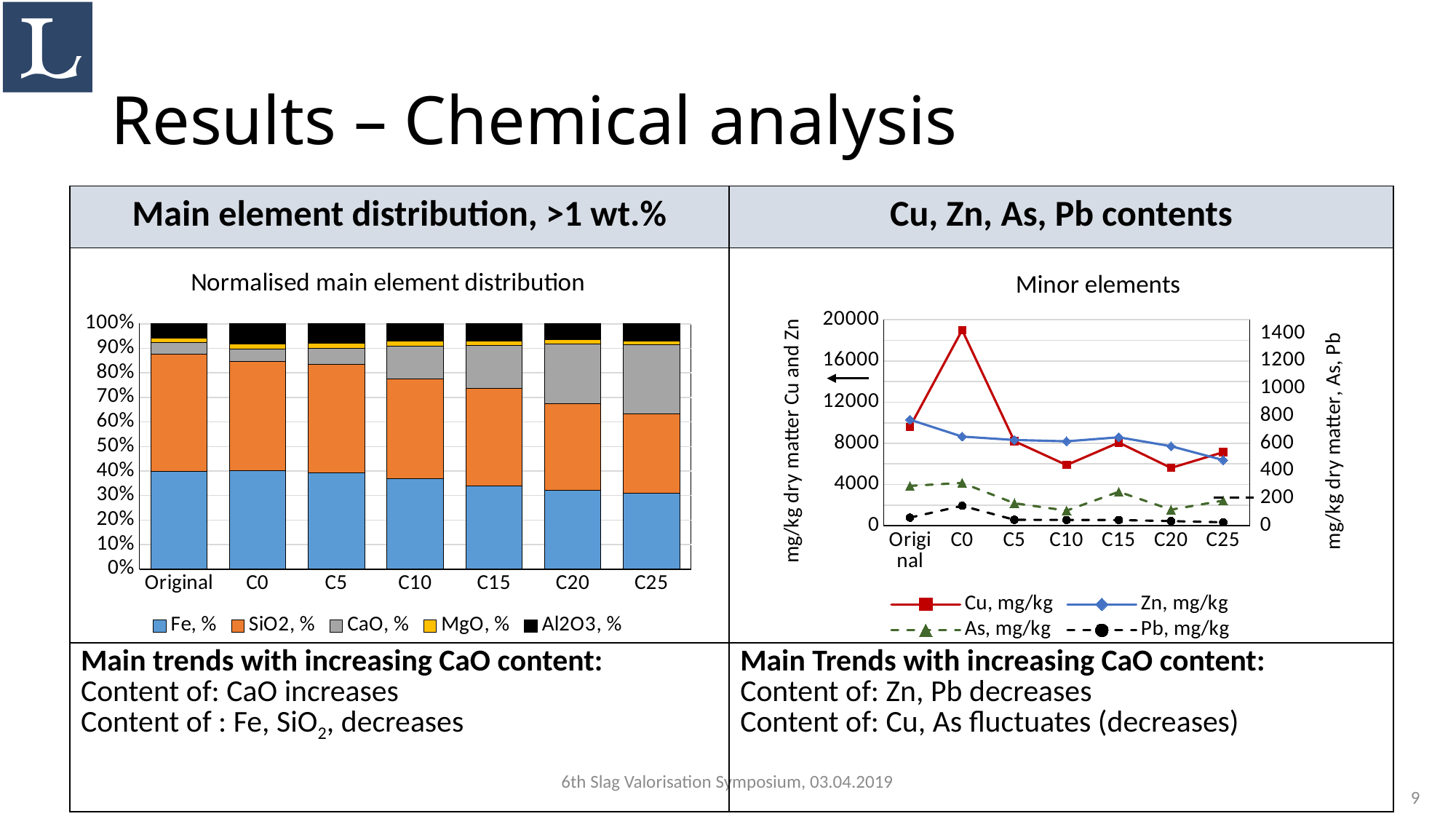
In the 'Minor elements' chart, does Zn, mg/kg generally rise or fall from Original to C25? fall In the 'Normalised main element distribution' chart, is the Fe, % value for Original greater or less than 30%? greater In the 'Minor elements' chart, at which category is Cu, mg/kg highest? C0 What type of chart is the 'Minor elements' chart? line chart In the 'Normalised main element distribution' chart, does the Fe, % share rise or fall from Original to C25? fall What type of chart is the 'Normalised main element distribution' chart? stacked bar chart Which series in the 'Minor elements' chart is drawn with a red line and square markers? Cu, mg/kg How many categories are shown on the x axis of the 'Minor elements' chart? 7 In the 'Minor elements' chart, is the Cu, mg/kg value for C0 greater or less than 16000? greater How many series does the legend of the 'Normalised main element distribution' chart list? 5 In the 'Minor elements' chart, which is larger at C10: Cu, mg/kg or Zn, mg/kg? Zn, mg/kg How many series does the legend of the 'Minor elements' chart list? 4